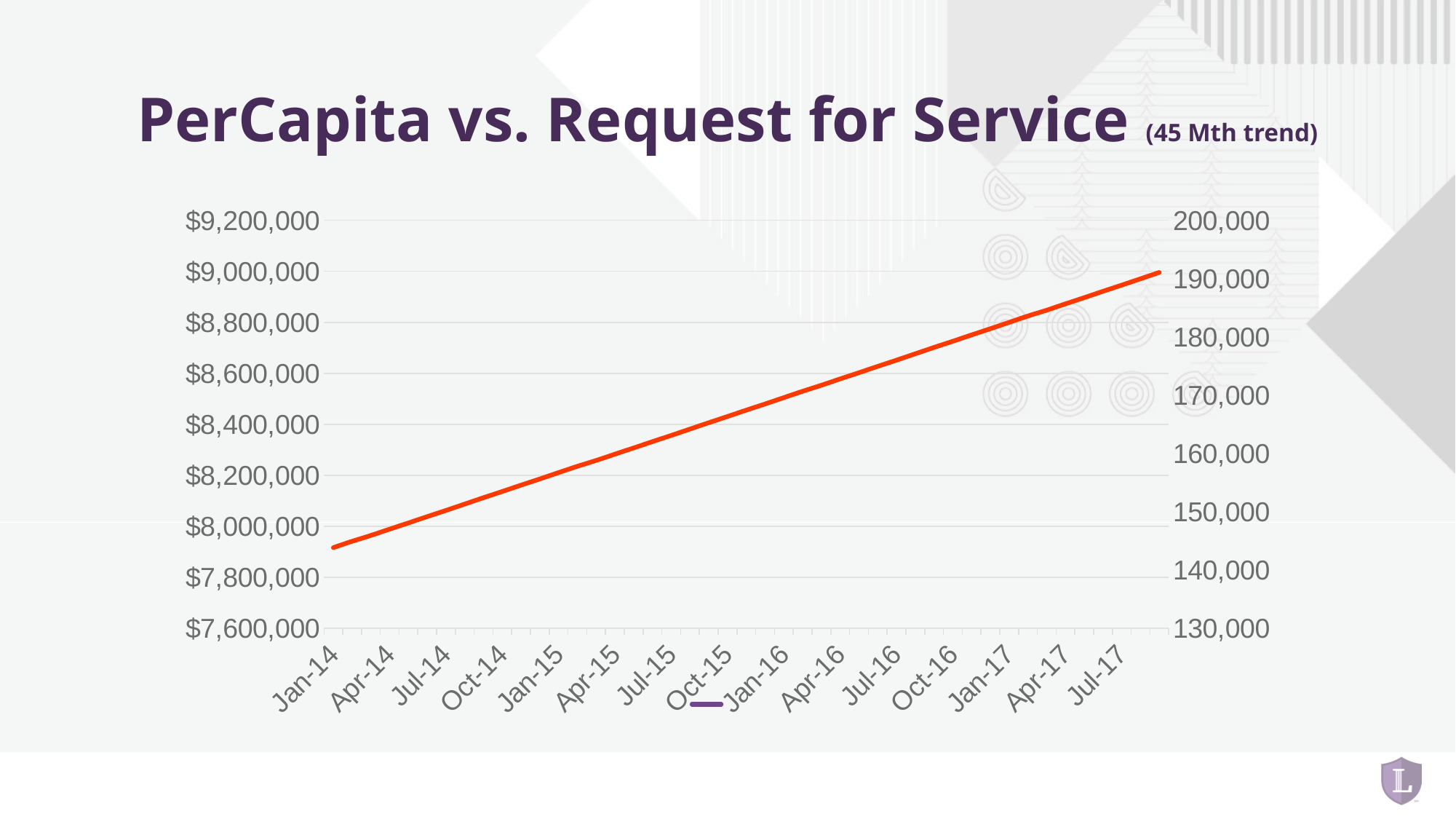
Which has the larger plotted value, Jan-14 or Jul-17? Jul-17 What kind of chart is shown on the slide? line chart What colour is the plotted line? red Do the plotted values rise or fall from Jan-14 to Jul-17? rise What is the last date label on the x axis? Jul-17 On the left-hand axis, is the value of the line at Jan-14 greater or less than $8,000,000? less What is the title of the chart on the slide? PerCapita vs. Request for Service (45 Mth trend) On the left-hand axis, is the value of the line at Jul-17 greater or less than $8,800,000? greater How many date labels are shown along the x axis? 15 At which x-axis date is the line at its lowest point? Jan-14 What is the first date label on the x axis? Jan-14